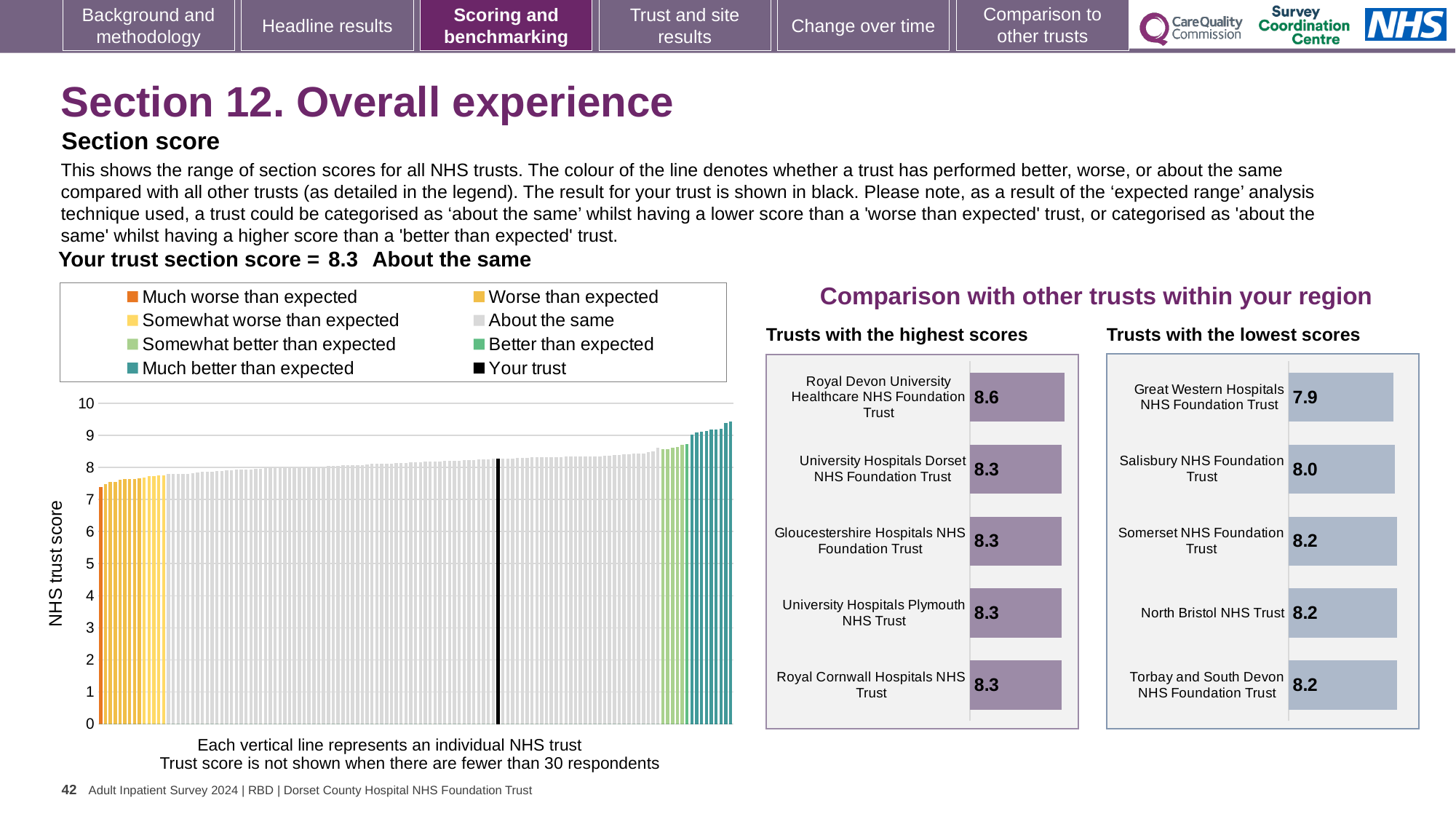
In the 'Trusts with the lowest scores' chart, which has the higher score: Salisbury NHS Foundation Trust or Somerset NHS Foundation Trust? Somerset NHS Foundation Trust In the NHS trust score chart on the left, is the value for the black 'Your trust' bar greater or less than 5? greater In the 'Trusts with the highest scores' chart, what is the score for Royal Devon University Healthcare NHS Foundation Trust? 8.6 In the 'Trusts with the lowest scores' chart, what is the score for Salisbury NHS Foundation Trust? 8.0 In the 'Trusts with the highest scores' chart, which trust has the highest score? Royal Devon University Healthcare NHS Foundation Trust In the NHS trust score chart on the left, what colour is used for 'Your trust' according to the legend? black In the 'Trusts with the lowest scores' chart, what is the score for Great Western Hospitals NHS Foundation Trust? 7.9 In the 'Trusts with the highest scores' chart, what is the difference between the scores of Royal Devon University Healthcare NHS Foundation Trust and University Hospitals Dorset NHS Foundation Trust? 0.3 How many entries does the legend of the NHS trust score chart on the left list? 8 In the 'Trusts with the lowest scores' chart, which trust has the lowest score? Great Western Hospitals NHS Foundation Trust How many trusts are shown in the 'Trusts with the highest scores' chart? 5 What kind of chart is the 'Trusts with the lowest scores' chart? bar chart